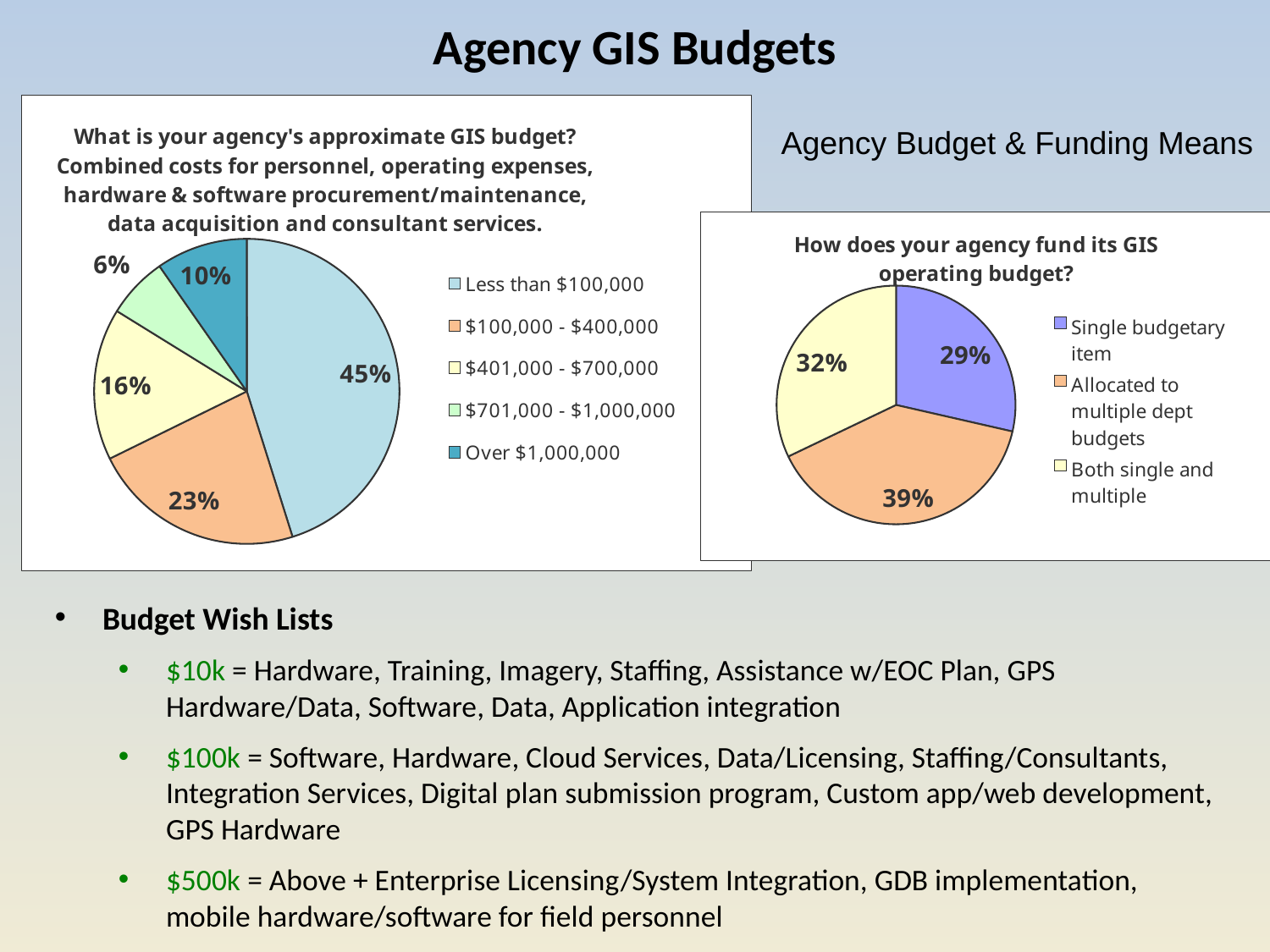
In the left pie chart on agency GIS budget, what is the difference in percentage points between the $401,000 - $700,000 slice and the $701,000 - $1,000,000 slice? 10 In the left pie chart on agency GIS budget, what share of agencies have a budget of $100,000 - $400,000? 23% In the left pie chart on agency GIS budget, which budget category has the smallest share? $701,000 - $1,000,000 In the left pie chart on agency GIS budget, what share of agencies have a budget of less than $100,000? 45% In the left pie chart on agency GIS budget, how many budget categories are shown? 5 In the right pie chart on how agencies fund their GIS operating budget, what share is a single budgetary item? 29% In the right pie chart on how agencies fund their GIS operating budget, which funding means has the largest share? Allocated to multiple dept budgets In the right pie chart on how agencies fund their GIS operating budget, which is larger: the share for 'Both single and multiple' or the share for 'Single budgetary item'? Both single and multiple In the left pie chart on agency GIS budget, what share of agencies have a budget over $1,000,000? 10% In the left pie chart on agency GIS budget, which budget category has the largest share? Less than $100,000 What type of chart is used for the 'How does your agency fund its GIS operating budget?' chart? Pie chart In the right pie chart on how agencies fund their GIS operating budget, what share is allocated to multiple dept budgets? 39%